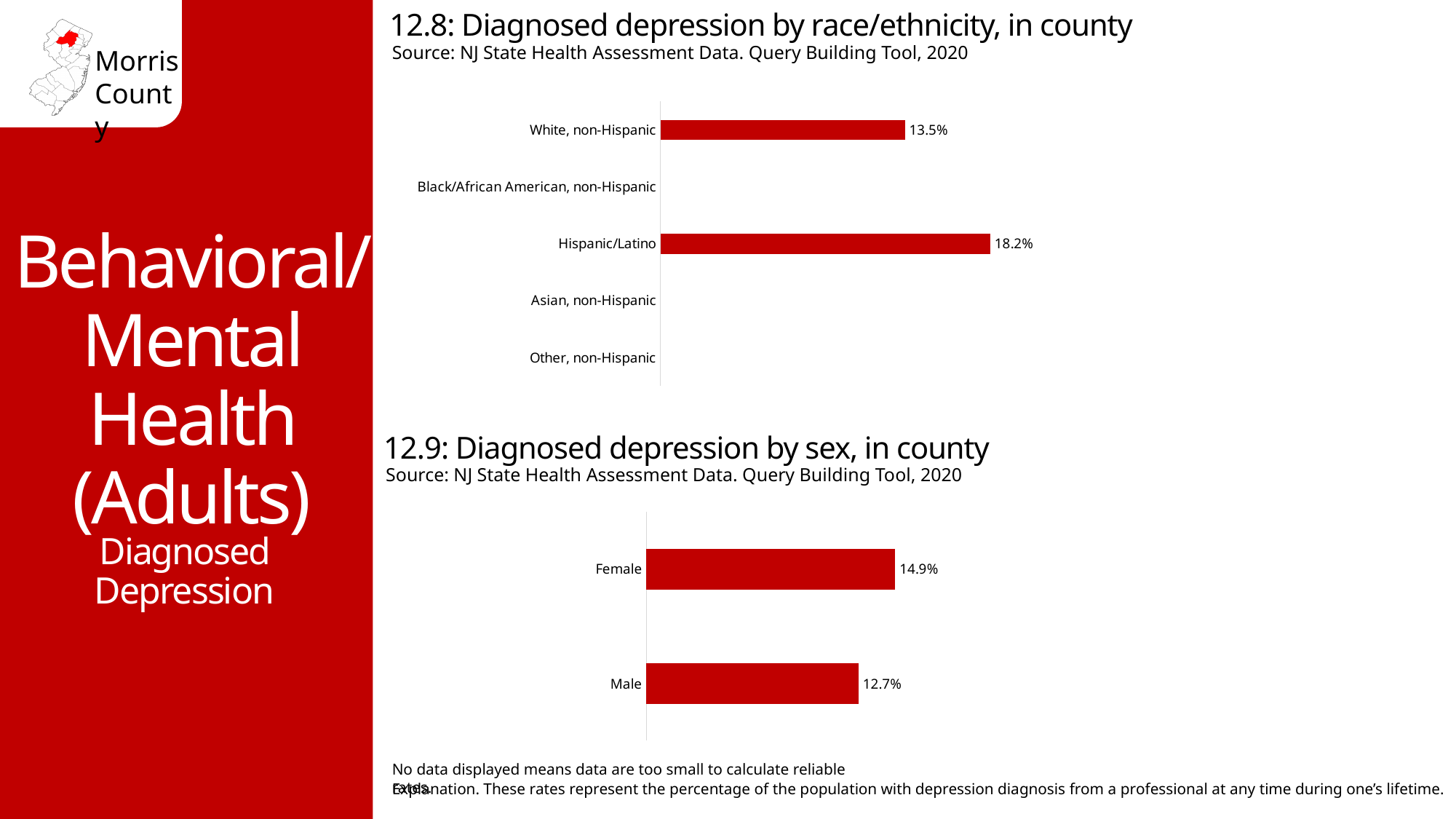
In the chart '12.8: Diagnosed depression by race/ethnicity, in county', what is the value for White, non-Hispanic? 13.5% In the chart '12.9: Diagnosed depression by sex, in county', what is the value for Male? 12.7% In the chart '12.8: Diagnosed depression by race/ethnicity, in county', what is the value for Hispanic/Latino? 18.2% In the chart '12.9: Diagnosed depression by sex, in county', what is the value for Female? 14.9% In the chart '12.9: Diagnosed depression by sex, in county', what is the difference between the Female and Male values? 2.2% What source is cited for the chart '12.9: Diagnosed depression by sex, in county'? NJ State Health Assessment Data. Query Building Tool, 2020 In the chart '12.9: Diagnosed depression by sex, in county', which is larger, Female or Male? Female In the chart '12.8: Diagnosed depression by race/ethnicity, in county', what is the difference between the Hispanic/Latino and White, non-Hispanic values? 4.7% What kind of chart is '12.8: Diagnosed depression by race/ethnicity, in county'? Bar chart In the chart '12.8: Diagnosed depression by race/ethnicity, in county', how many categories are listed on the axis? 5 In the chart '12.8: Diagnosed depression by race/ethnicity, in county', which category has the highest value? Hispanic/Latino In the chart '12.8: Diagnosed depression by race/ethnicity, in county', how many categories have a bar displayed? 2